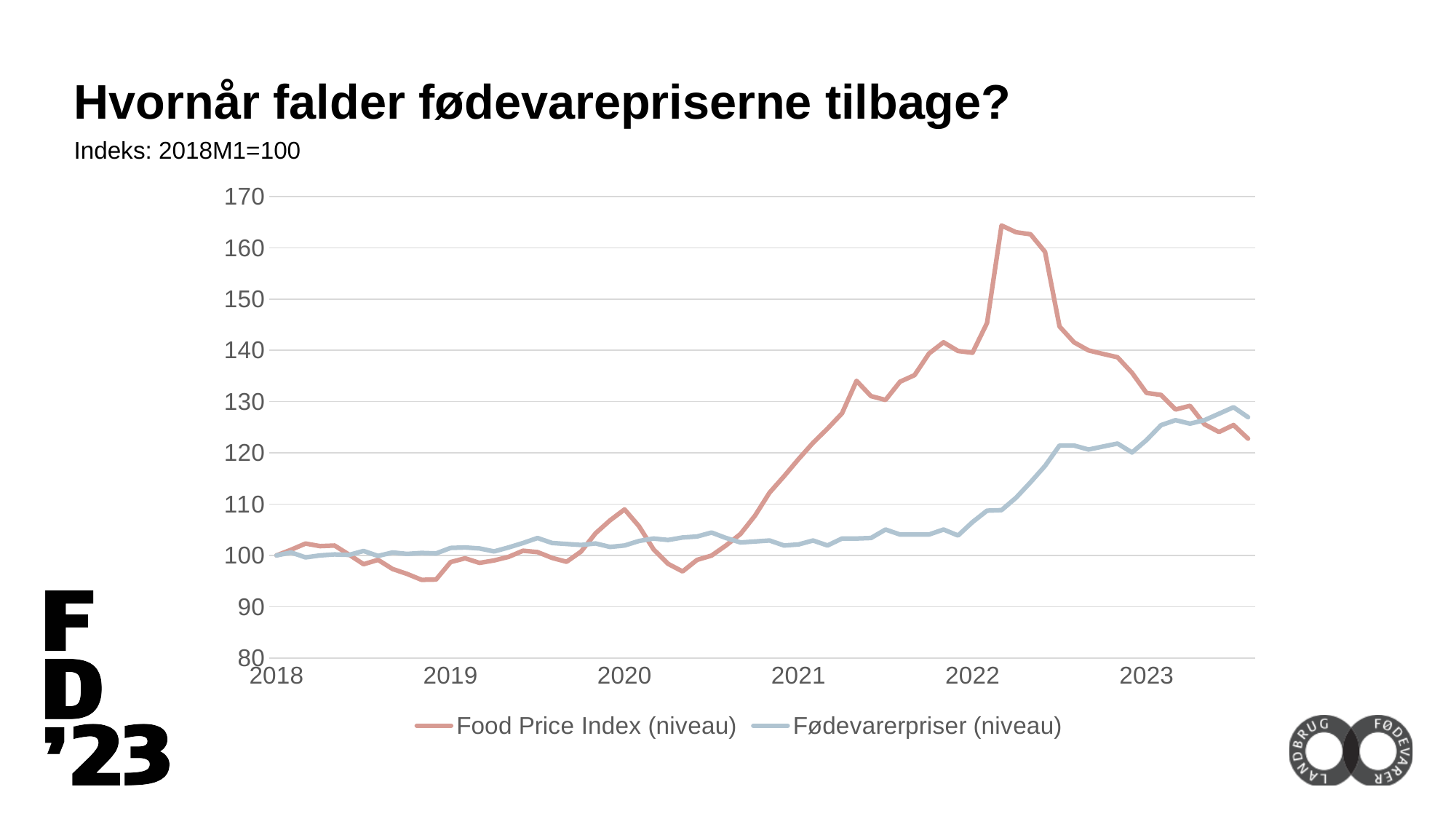
Which series reaches the highest value on the chart? Food Price Index (niveau) Does the Fødevarerpriser (niveau) series rise or fall between 2021 and 2023? rise What kind of chart is shown on the slide? line chart Is the value of Fødevarerpriser (niveau) at the start of 2022 greater or less than 110? less Is the lowest value of the Food Price Index (niveau) series, in late 2018, greater or less than 100? less Is the value of Fødevarerpriser (niveau) at the start of 2023 greater or less than 120? greater How many series does the legend list? 2 What are the two series named in the legend? Food Price Index (niveau) and Fødevarerpriser (niveau) At the last plotted point, which series is higher: Food Price Index (niveau) or Fødevarerpriser (niveau)? Fødevarerpriser (niveau) At the start of 2022, which series is higher: Food Price Index (niveau) or Fødevarerpriser (niveau)? Food Price Index (niveau) What is the title of the slide? Hvornår falder fødevarepriserne tilbage?